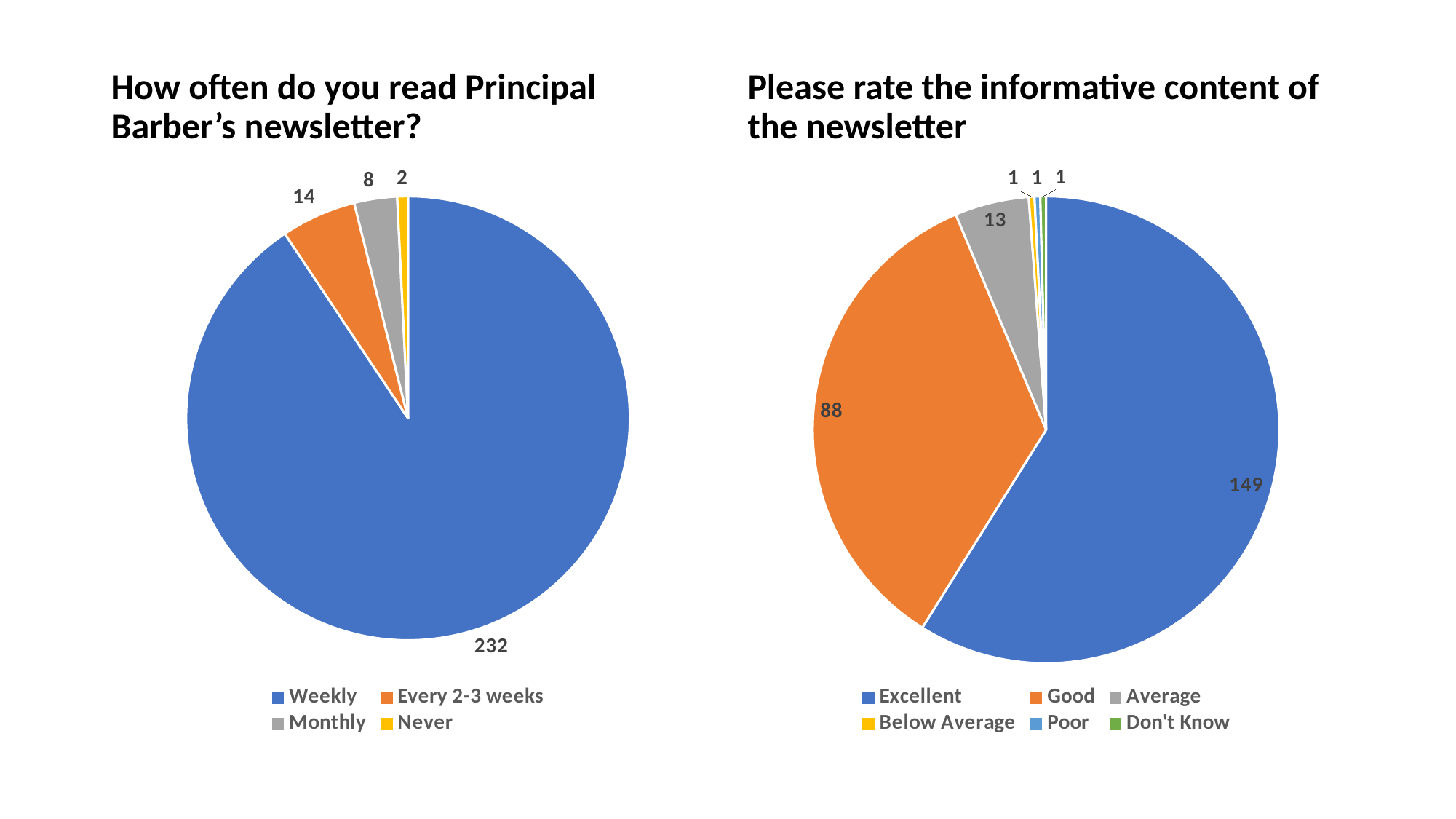
In the chart titled "How often do you read Principal Barber's newsletter?", how many categories does the legend list? 4 In the chart titled "Please rate the informative content of the newsletter", which colour represents Good? Orange In the chart titled "Please rate the informative content of the newsletter", what is the difference between Excellent and Good? 61 In the chart titled "Please rate the informative content of the newsletter", what is the value for Good? 88 In the chart titled "How often do you read Principal Barber's newsletter?", what is the value for Weekly? 232 What type of chart is the chart on the left of the slide? Pie chart In the chart titled "How often do you read Principal Barber's newsletter?", what is the difference between Weekly and Every 2-3 weeks? 218 In the chart titled "Please rate the informative content of the newsletter", what is the value for Average? 13 In the chart titled "How often do you read Principal Barber's newsletter?", what is the value for Monthly? 8 In the chart titled "How often do you read Principal Barber's newsletter?", which category has the smallest slice? Never In the chart titled "Please rate the informative content of the newsletter", which category has the largest slice? Excellent In the chart titled "Please rate the informative content of the newsletter", how many categories does the legend list? 6